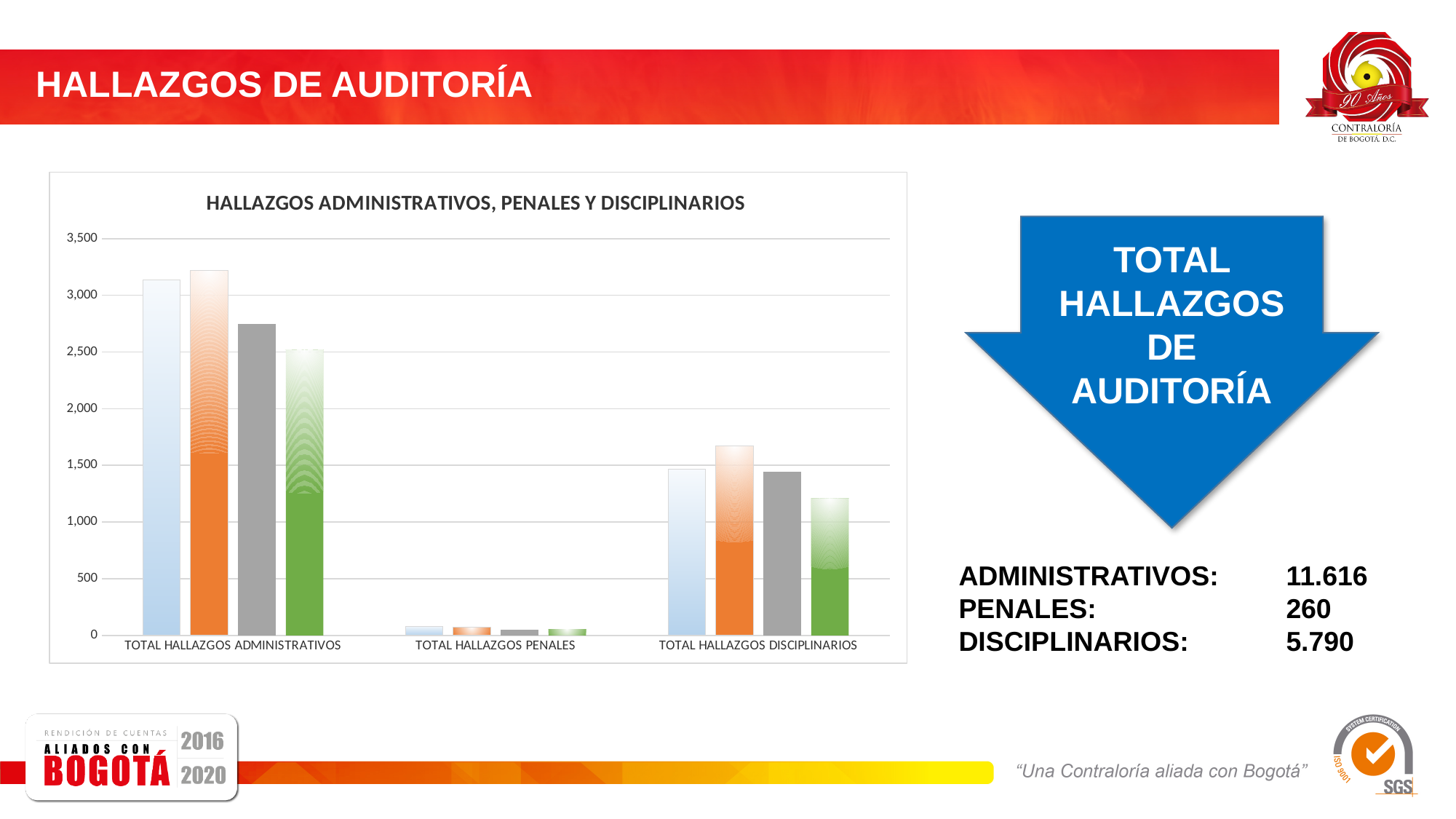
Are the bars for TOTAL HALLAZGOS ADMINISTRATIVOS taller or shorter than those for TOTAL HALLAZGOS DISCIPLINARIOS? taller Is the value of the second (orange) bar for TOTAL HALLAZGOS DISCIPLINARIOS greater or less than 1,500? greater Which category has the shortest bars in the chart? TOTAL HALLAZGOS PENALES Are all the bars for TOTAL HALLAZGOS PENALES greater or less than 500? less What is the title of the chart? HALLAZGOS ADMINISTRATIVOS, PENALES Y DISCIPLINARIOS How many bars are plotted for each category in the chart? 4 What kind of chart is shown on the slide? bar chart Is the value of the fourth (green) bar for TOTAL HALLAZGOS DISCIPLINARIOS greater or less than 1,500? less How many categories are shown on the x axis of the chart? 3 Which category has the tallest bars in the chart? TOTAL HALLAZGOS ADMINISTRATIVOS